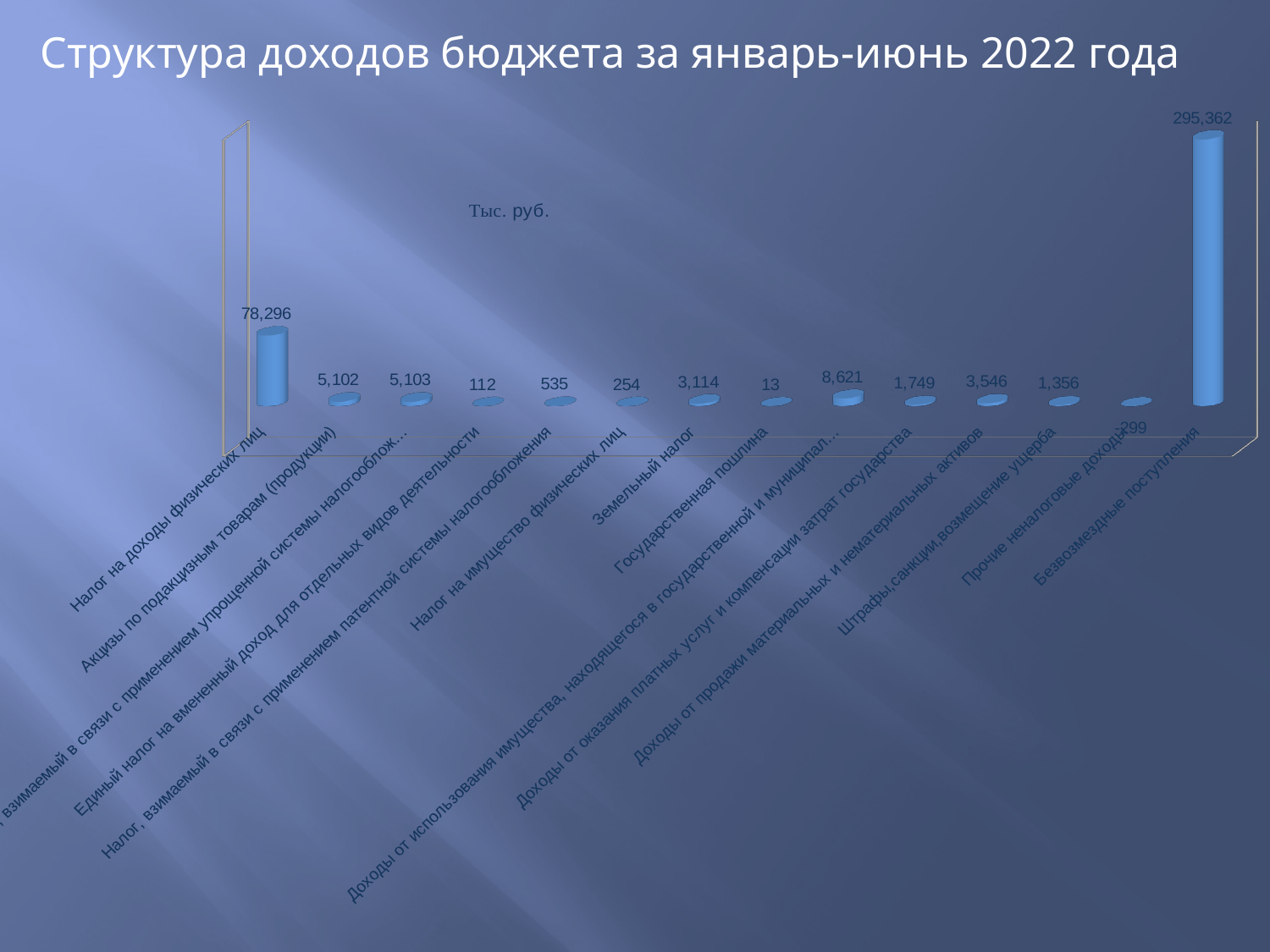
What is the value for Земельный налог? 3,114 Which category has the highest value? Безвозмездные поступления What is the difference between the values for Безвозмездные поступления and Налог на доходы физических лиц? 217,066 What is the value for Безвозмездные поступления? 295,362 What kind of chart is shown on the slide? Bar chart What is the value for Прочие неналоговые доходы? -299 What unit label is shown on the chart? Тыс. руб. What is the value for Налог на доходы физических лиц? 78,296 Which category has the lowest value? Прочие неналоговые доходы Which is larger: the value for Доходы от продажи материальных и нематериальных активов or the value for Штрафы, санкции, возмещение ущерба? Доходы от продажи материальных и нематериальных активов How many categories are shown in the chart? 14 What is the value for Государственная пошлина? 13